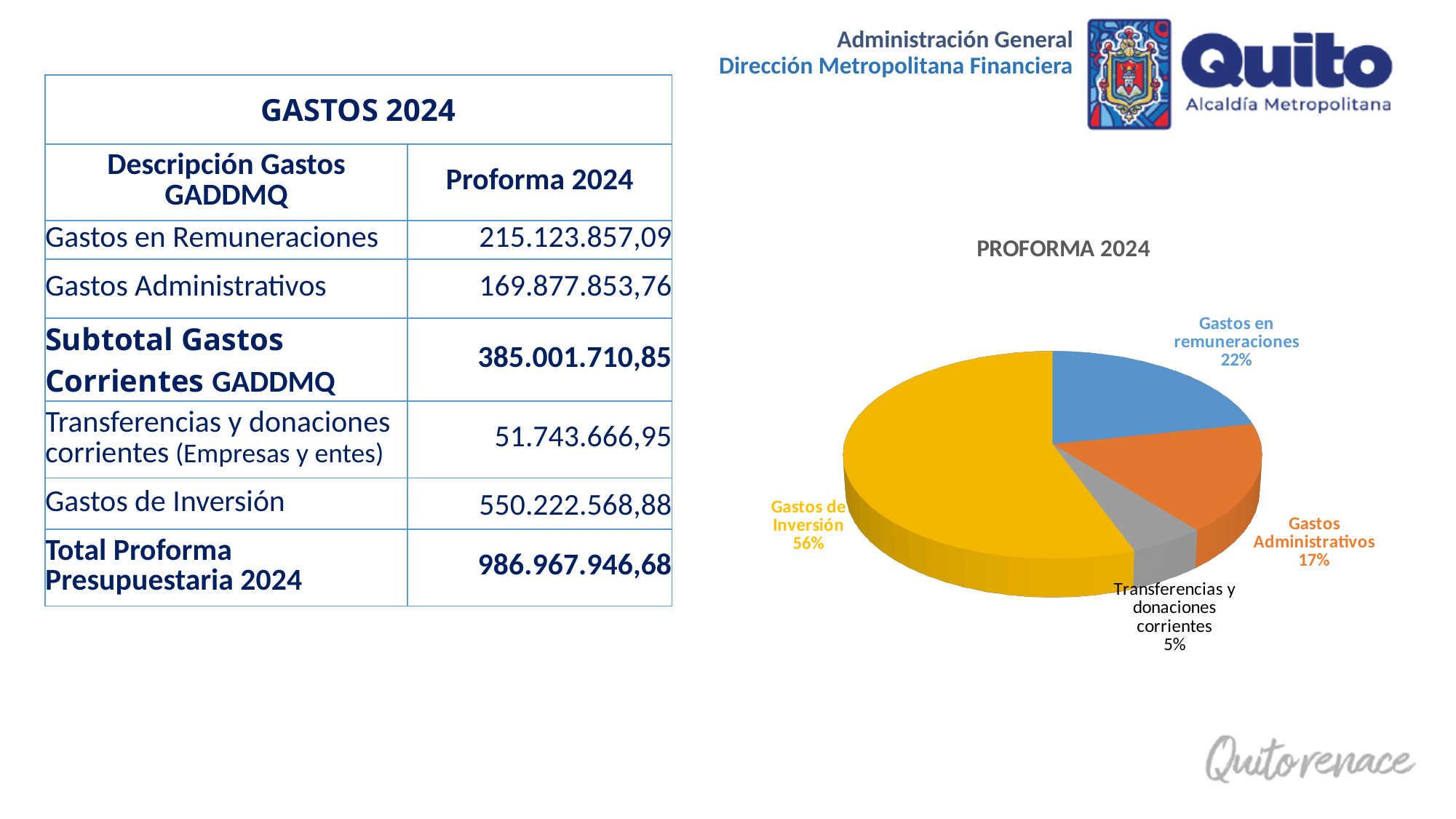
Which is larger in the pie chart, Gastos en remuneraciones or Gastos Administrativos? Gastos en remuneraciones How many slices does the pie chart have? 4 What is the difference in percentage points between Gastos de Inversión and Gastos en remuneraciones? 34 What share of the pie does Gastos en remuneraciones represent? 22% Which slice of the pie chart is the largest? Gastos de Inversión What share of the pie does Gastos Administrativos represent? 17% What kind of chart is shown on the slide? pie chart What share of the pie does Gastos de Inversión represent? 56% Which slice of the pie chart is the smallest? Transferencias y donaciones corrientes What is the title of the chart? PROFORMA 2024 What colour is the Gastos de Inversión slice in the pie chart? yellow